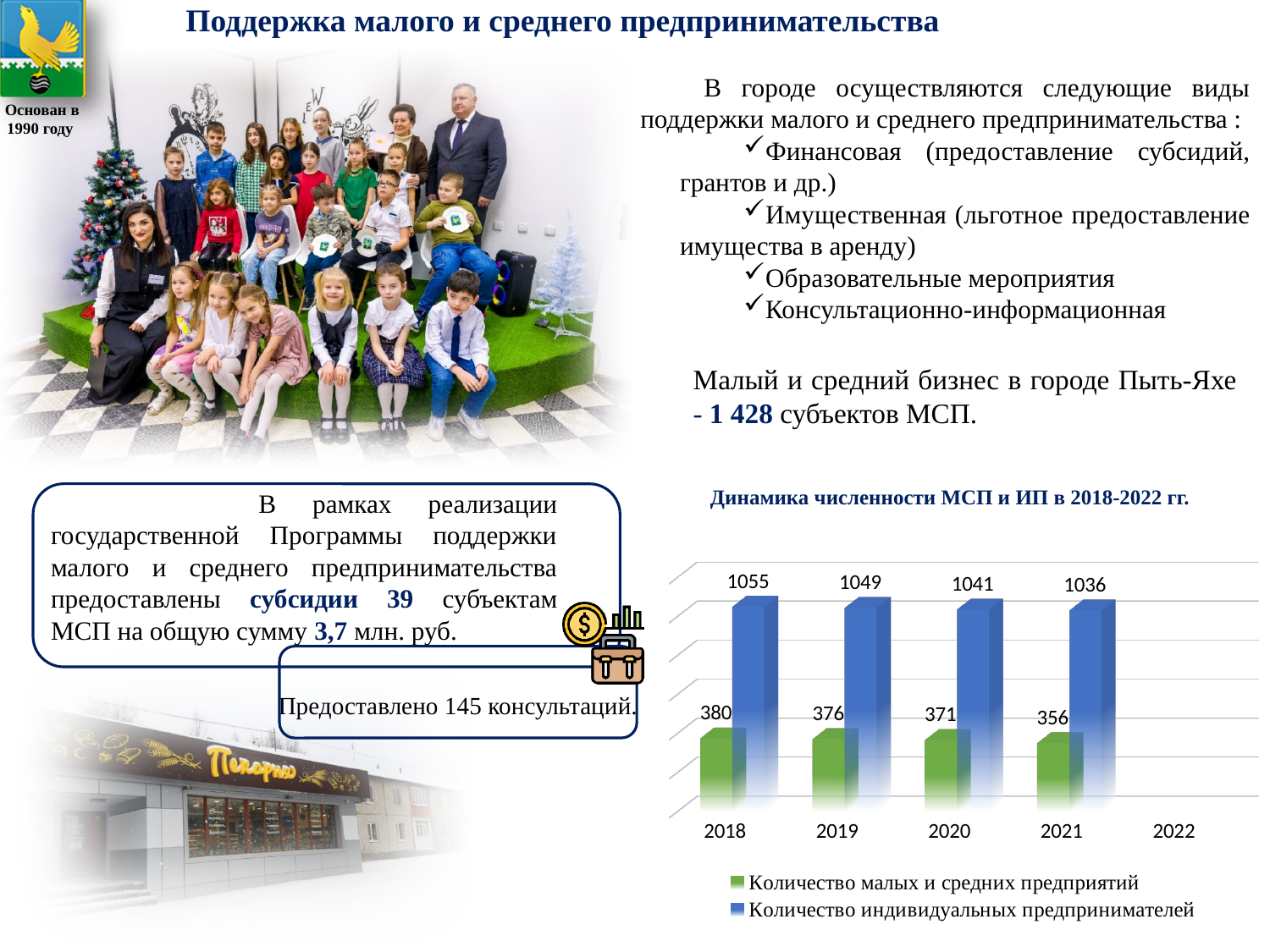
What is the value for "Количество индивидуальных предпринимателей" in 2018? 1055 Do the values for "Количество индивидуальных предпринимателей" rise or fall from 2018 to 2021? Fall What is the difference between the 2018 and 2021 values for "Количество индивидуальных предпринимателей"? 19 What is the difference between the 2018 and 2021 values for "Количество малых и средних предприятий"? 24 What type of chart is shown under the title "Динамика численности МСП и ИП в 2018-2022 гг."? Bar chart What is the value for "Количество индивидуальных предпринимателей" in 2020? 1041 How many series does the legend of the chart list? 2 What is the value for "Количество малых и средних предприятий" in 2021? 356 Which colour represents "Количество малых и средних предприятий" in the chart? Green In which year is the value for "Количество малых и средних предприятий" the highest? 2018 In which year is the value for "Количество индивидуальных предпринимателей" the lowest? 2021 What is the value for "Количество малых и средних предприятий" in 2019? 376